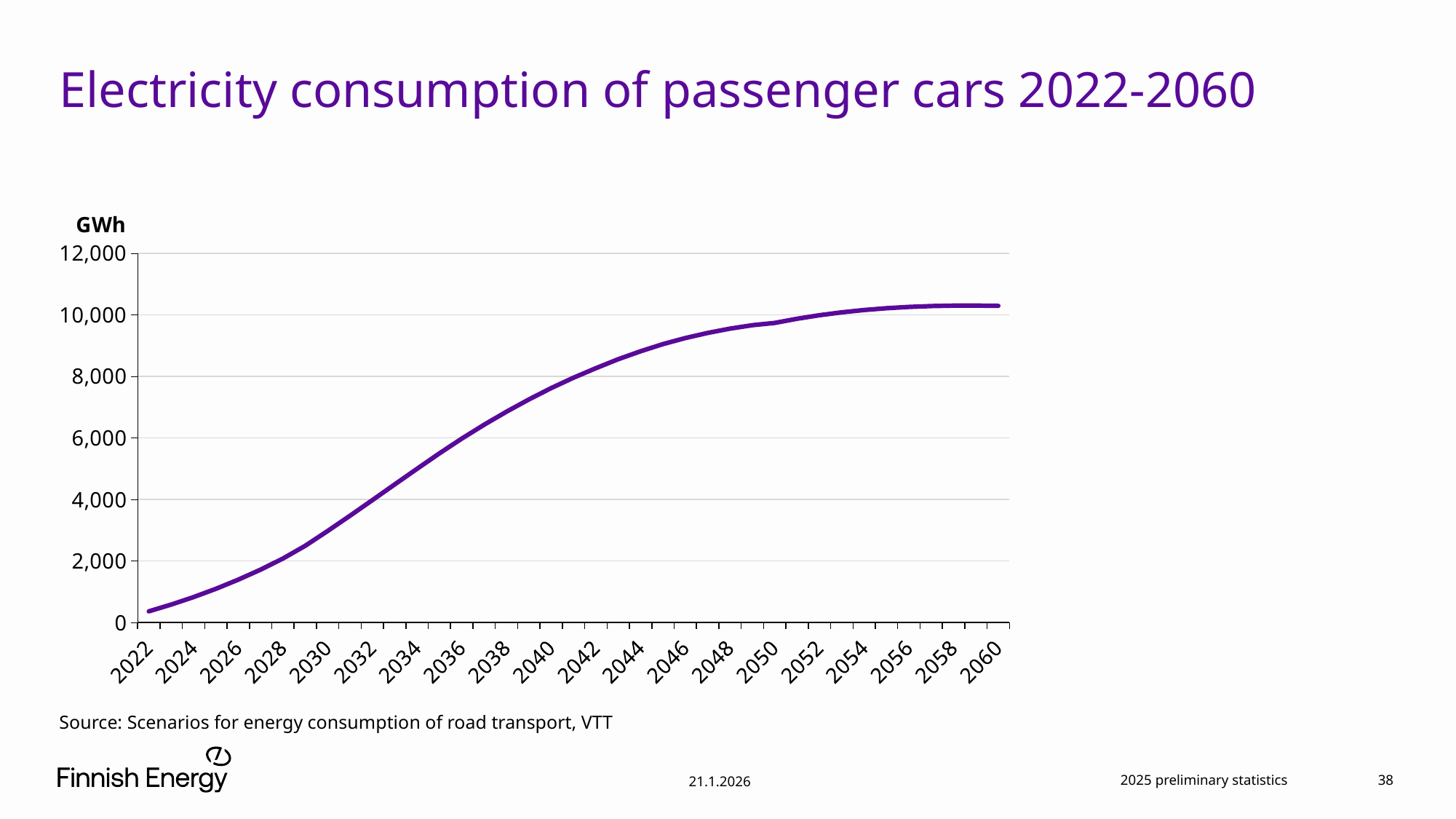
Is the value for 2026 greater or less than 2,000? less Is the value for 2022 greater or less than 2,000? less Is the value for 2030 greater or less than 2,000? greater Which year has the lowest electricity consumption on the chart? 2022 What kind of chart is shown on the slide? line chart How many year labels are shown on the x axis? 20 Do the values rise or fall along the x axis from 2022 to 2060? rise What is the title of the chart on the slide? Electricity consumption of passenger cars 2022-2060 Which is larger, the value for 2030 or the value for 2040? 2040 What unit is shown on the y axis of the chart? GWh